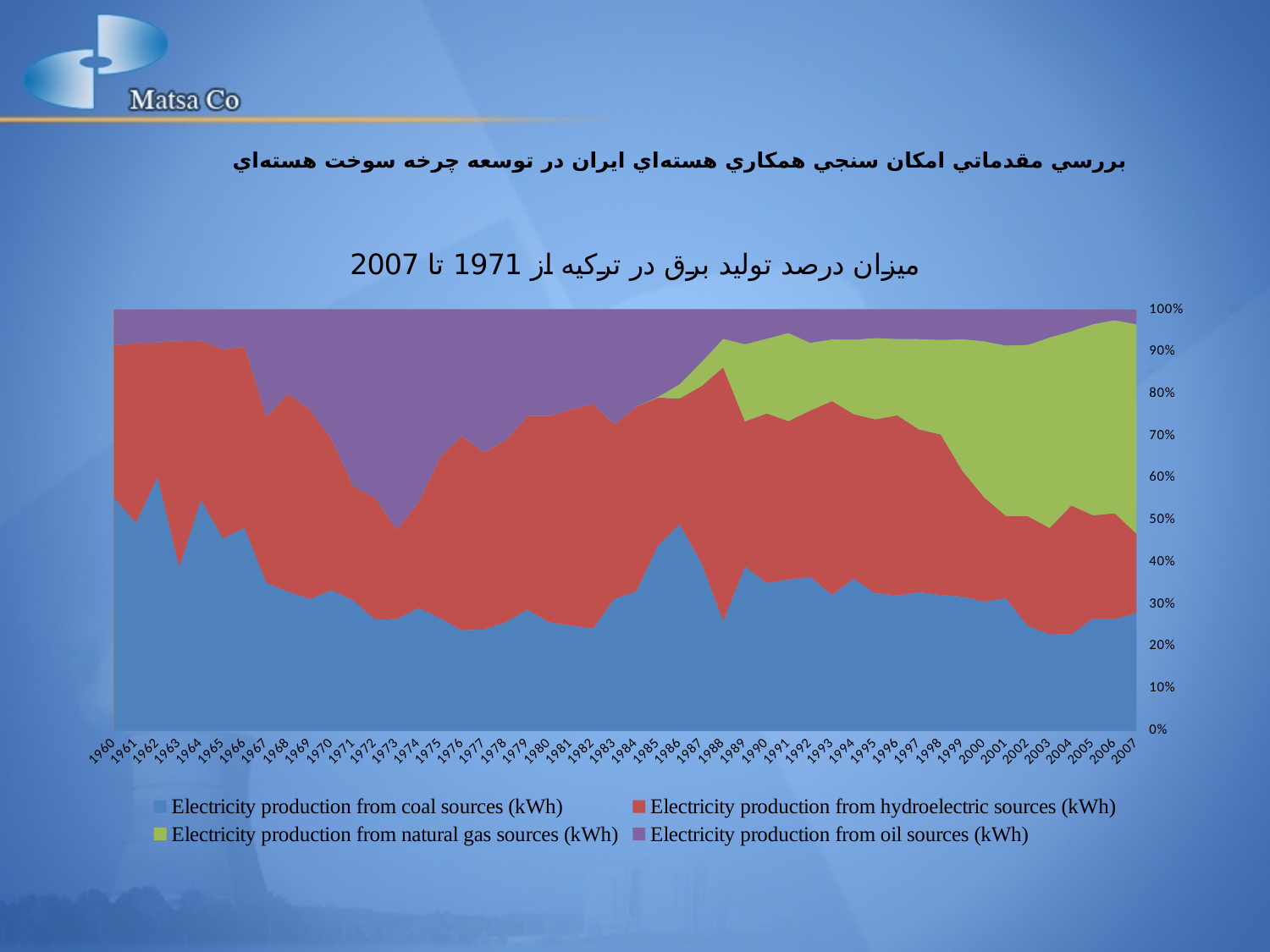
How many series does the legend list? 4 How many years are plotted along the x axis? 48 What is the first year shown on the x axis? 1960 Is the share of electricity production from coal sources in 1986 greater or less than 40%? greater What kind of chart is shown on the slide? Stacked area chart Is the share of electricity production from oil sources in 1973 greater or less than 30%? greater Which source has the largest share of electricity production in 2007? Electricity production from natural gas sources (kWh) Which series is shown in green in the legend? Electricity production from natural gas sources (kWh) Does the share of electricity production from natural gas sources rise or fall from 1985 to 2007? rise Is the share of electricity production from coal sources in 2007 greater or less than 40%? less Which source has the largest share of electricity production in 1960? Electricity production from coal sources (kWh)